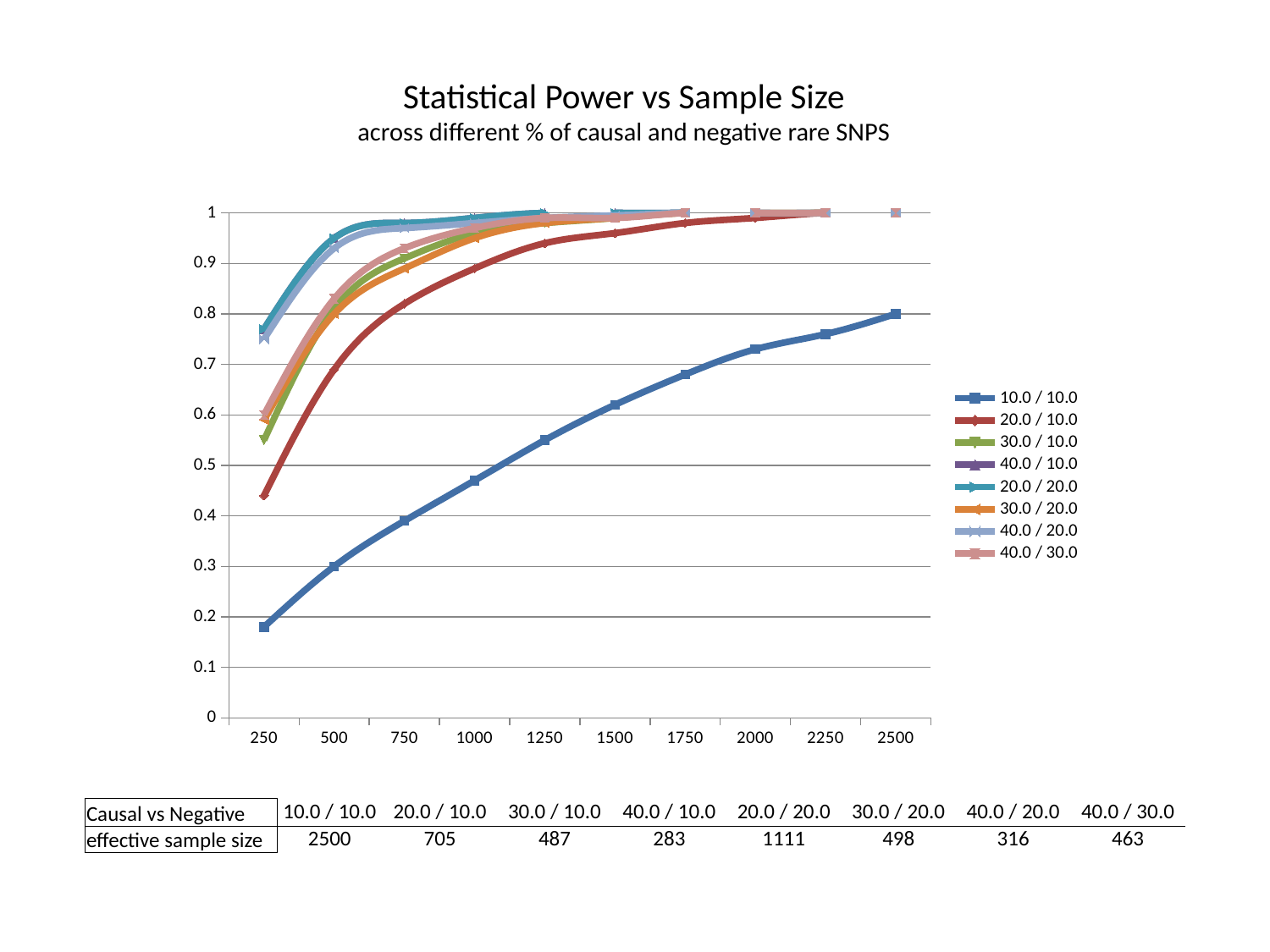
Is the value for the 20.0 / 10.0 series at sample size 250 greater or less than 0.5? less What kind of chart is shown on the slide? line chart What is the main title of the chart? Statistical Power vs Sample Size Does the 10.0 / 10.0 series rise or fall as sample size increases? rises Is the value for the 10.0 / 10.0 series at sample size 250 greater or less than 0.2? less How many series does the legend list? 8 What is the value of the 10.0 / 10.0 series at sample size 2500? 0.8 Which series has the lowest statistical power at sample size 250? 10.0 / 10.0 How many sample-size values are marked along the x axis? 10 Which series is listed first in the legend? 10.0 / 10.0 Is the value for the 10.0 / 10.0 series at sample size 1000 greater or less than 0.4? greater At sample size 500, which series has the higher value: 20.0 / 10.0 or 10.0 / 10.0? 20.0 / 10.0